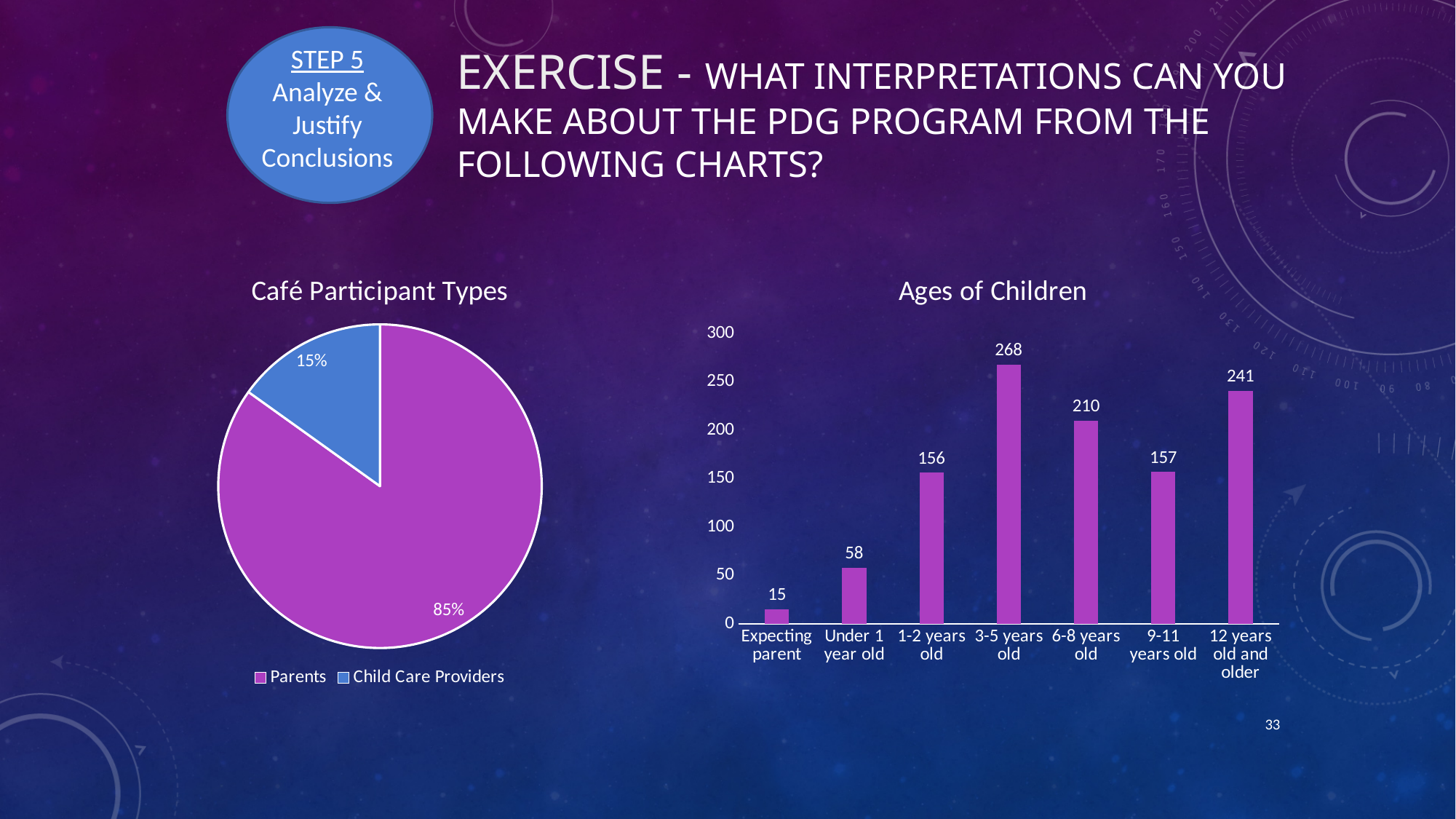
In the 'Café Participant Types' chart, what share of the pie is Child Care Providers? 15% In the 'Ages of Children' chart, how many categories are shown on the x axis? 7 In the 'Ages of Children' chart, what is the value for Expecting parent? 15 In the 'Café Participant Types' chart, what share of the pie is Parents? 85% In the 'Ages of Children' chart, what is the value for 3-5 years old? 268 In the 'Ages of Children' chart, what is the difference between the values for 3-5 years old and 6-8 years old? 58 In the 'Ages of Children' chart, which category has the highest value? 3-5 years old How many entries does the legend of the 'Café Participant Types' chart list? 2 What kind of chart is 'Café Participant Types'? Pie chart In the 'Ages of Children' chart, which category has the lowest value? Expecting parent What kind of chart is 'Ages of Children'? Bar chart In the 'Ages of Children' chart, which is larger: the value for 12 years old and older or the value for 6-8 years old? 12 years old and older